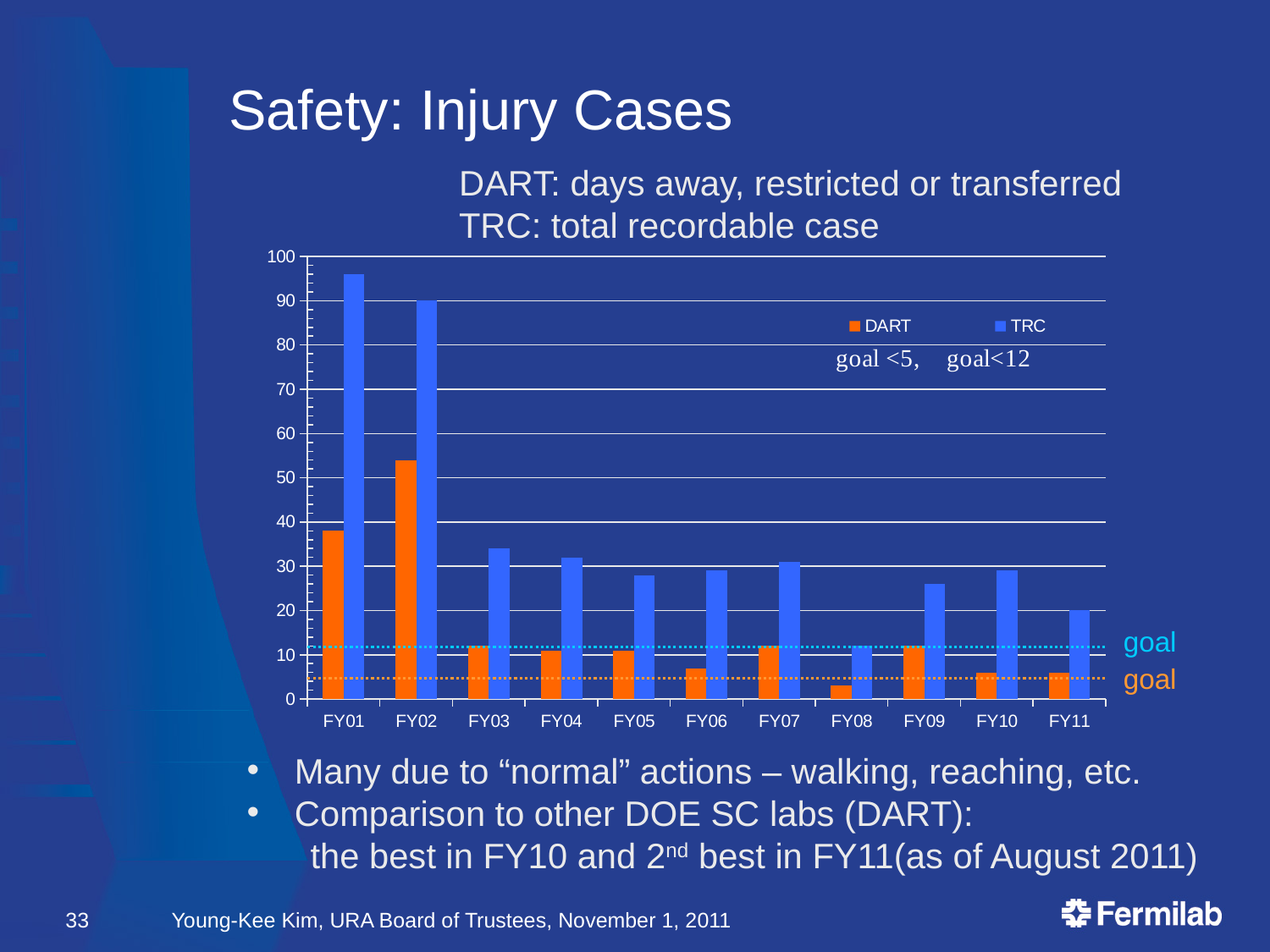
Is the TRC value for FY11 greater or less than 30? less Is the DART value for FY02 greater or less than 50? greater Which fiscal year has the lowest TRC value? FY08 What kind of chart is shown on the slide? bar chart How many series does the chart legend list? 2 Which fiscal year has the lowest DART value? FY08 What goal is stated for DART in the chart legend area? goal <5 Is the TRC value for FY01 greater or less than 90? greater Which fiscal year has the highest DART value? FY02 Which is larger, the DART value for FY01 or the DART value for FY02? FY02 Which fiscal year has the highest TRC value? FY01 How many fiscal years are shown on the x axis of the chart? 11